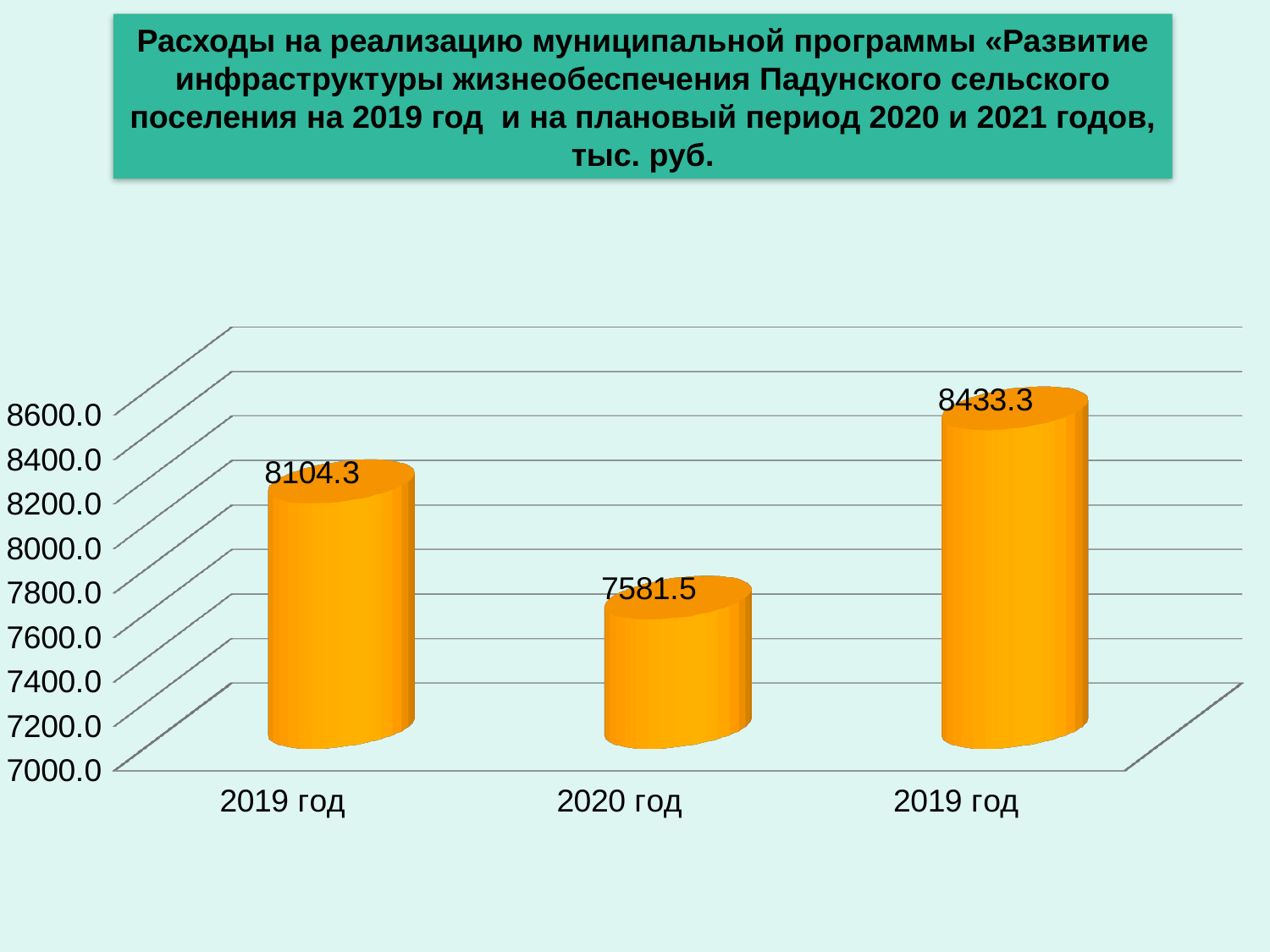
What is the value shown on the leftmost bar (the first 2019 год bar)? 8104.3 What is the difference between the leftmost bar (8104.3) and the 2020 год bar? 522.8 Is the value for 2020 год greater or less than 7800.0? less How many bars are plotted in the chart? 3 Which is larger: the value for 2020 год or the value of the leftmost bar? The leftmost bar (8104.3) Which category has the lowest value? 2020 год What is the difference between the rightmost bar (8433.3) and the leftmost bar (8104.3)? 329.0 What is the value shown on the rightmost bar? 8433.3 Which bar has the highest value? The rightmost bar (8433.3) What is the value for 2020 год? 7581.5 What kind of chart is shown on the slide? Bar chart Does the value fall or rise from the first bar to the second bar (2020 год)? Fall